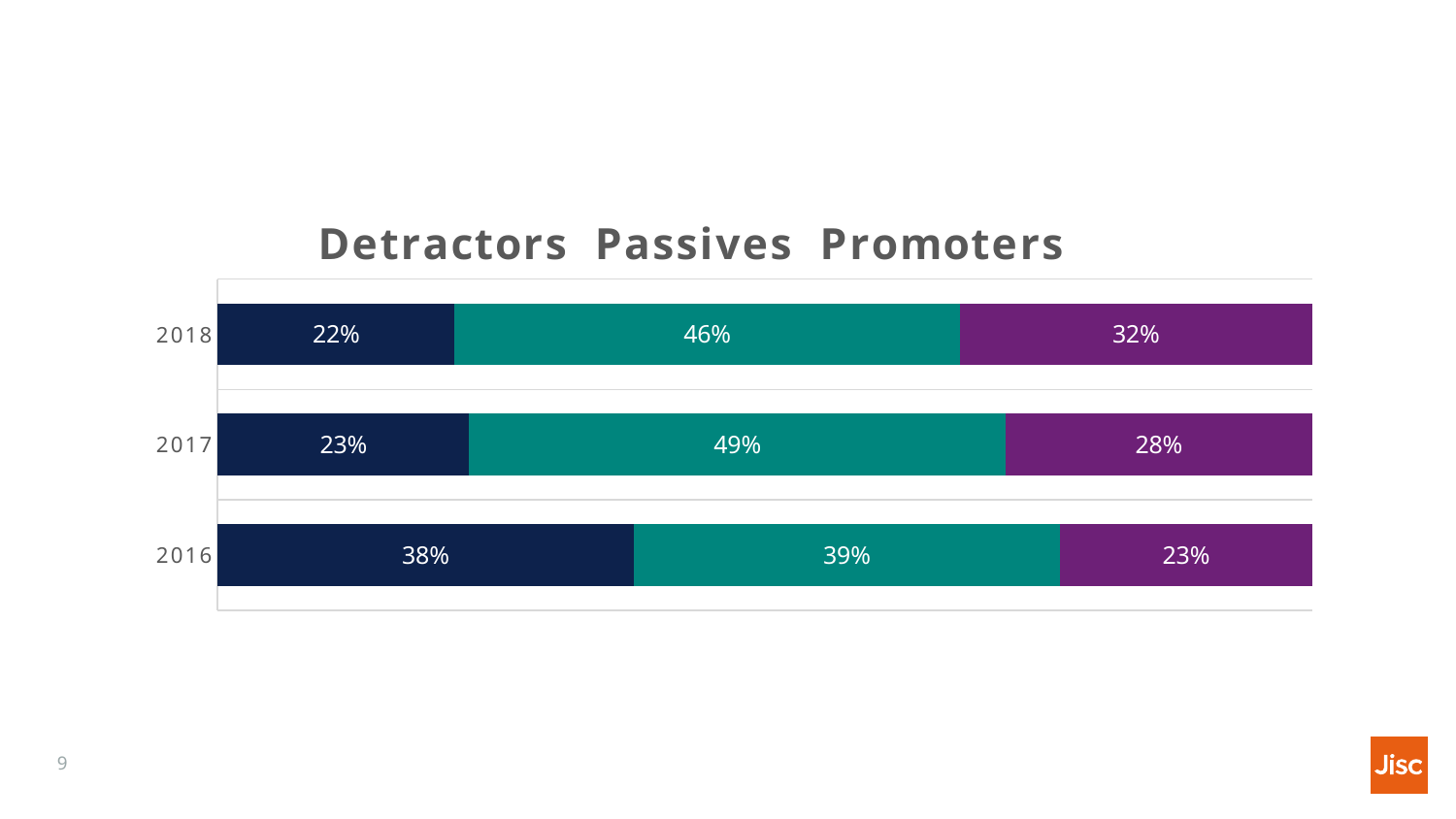
What is the difference between the Detractors share in 2016 and in 2018? 16 percentage points Which year has the lowest share of Detractors? 2018 How many series does the chart show? 3 What percentage of respondents were Promoters in 2017? 28% What kind of chart is shown on the slide? Stacked bar chart What percentage of respondents were Detractors in 2016? 38% Which year has the highest share of Promoters? 2018 How many years are shown on the chart? 3 Which is larger in 2017: the share of Passives or the share of Promoters? Passives What percentage of respondents were Passives in 2018? 46% Does the share of Promoters rise or fall from 2016 to 2018? Rise What is the total of the three segments in the 2016 bar? 100%